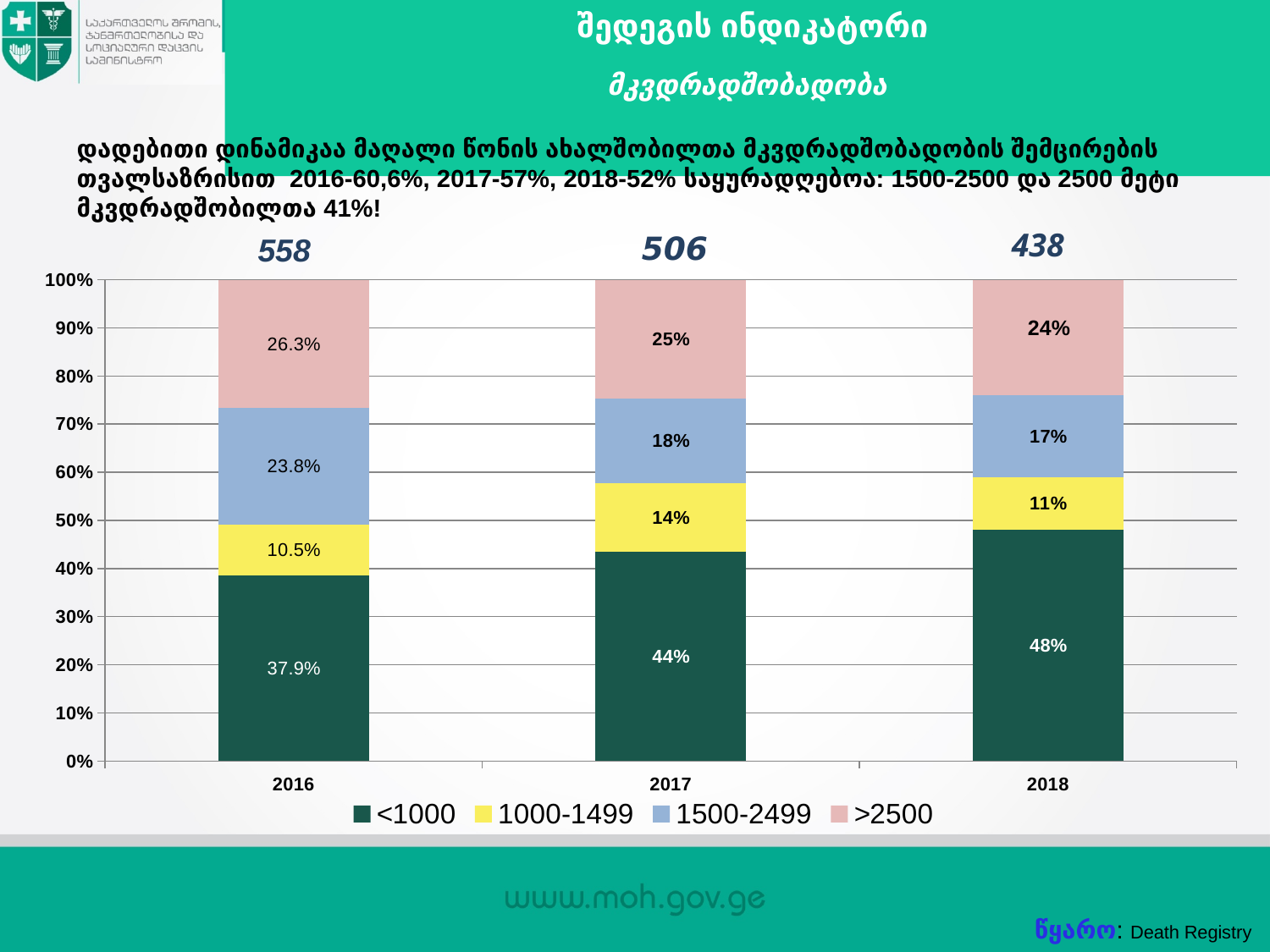
Which is larger in 2017: the 1000-1499 share or the 1500-2499 share? 1500-2499 What is the difference between the <1000 share in 2018 and in 2017? 4% In which year is the 1500-2499 share the lowest? 2018 In which year is the <1000 share the highest? 2018 What number is printed above the 2018 bar? 438 What is the value for the <1000 series in 2016? 37.9% What is the value for the 1500-2499 series in 2016? 23.8% How many series does the legend list? 4 How many years are shown on the x axis? 3 What is the value for the >2500 series in 2017? 25% What kind of chart is shown? Stacked bar chart What is the value for the 1000-1499 series in 2018? 11%